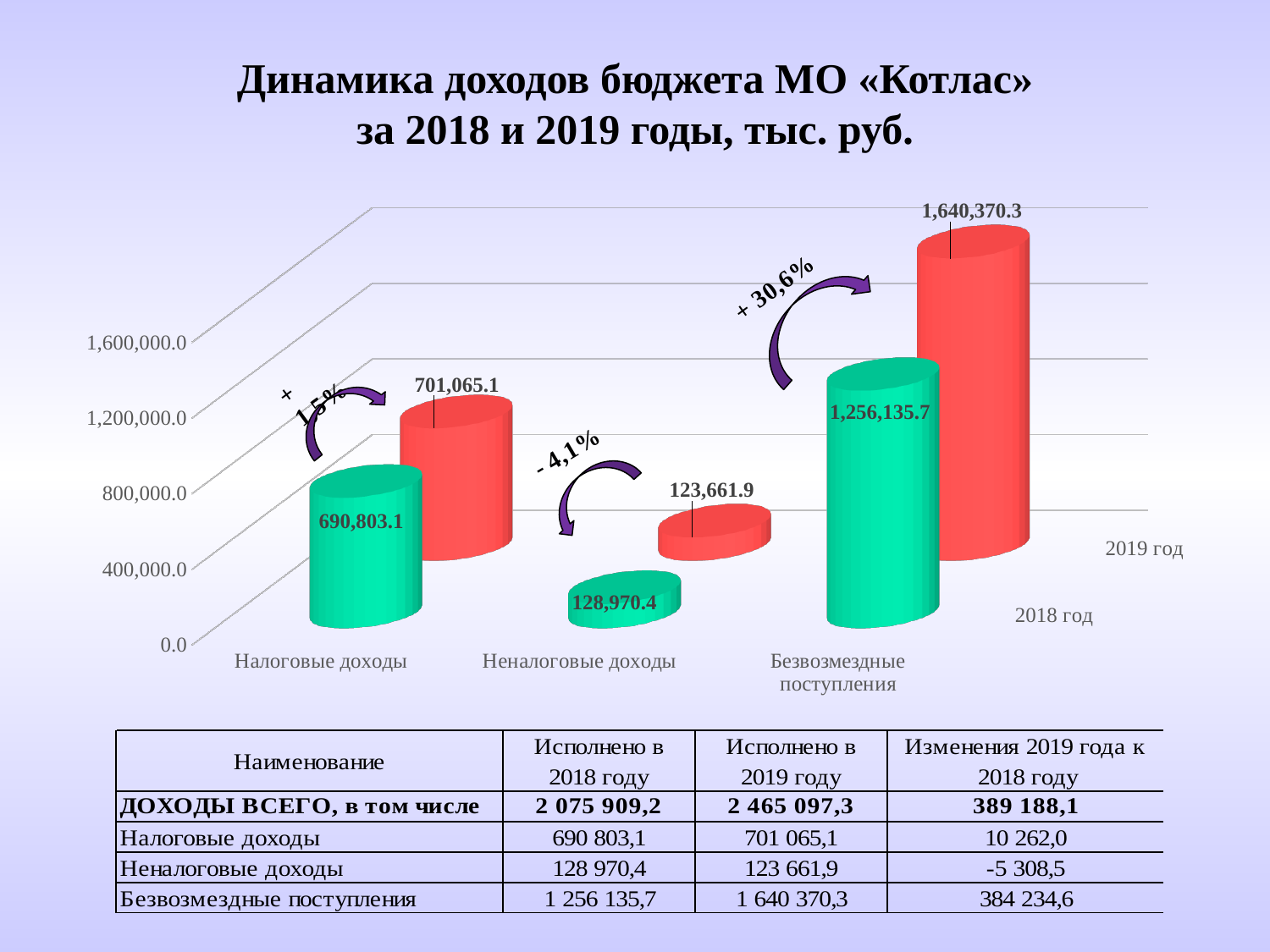
What is the value for Неналоговые доходы in 2019 год? 123,661.9 Which category has the highest value in 2019 год? Безвозмездные поступления Which is larger for Налоговые доходы: the 2018 год value or the 2019 год value? 2019 год What kind of chart is shown on the slide? bar chart What is the difference between the 2018 год and 2019 год values for Неналоговые доходы? 5,308.5 Which category has the lowest value in 2018 год? Неналоговые доходы What is the value for Налоговые доходы in 2018 год? 690,803.1 What percentage change is shown above the Безвозмездные поступления bars? + 30,6% What is the value for Безвозмездные поступления in 2019 год? 1,640,370.3 How many categories are shown on the x axis of the chart? 3 What is the difference between the 2019 год and 2018 год values for Безвозмездные поступления? 384,234.6 How many series does the chart show? 2